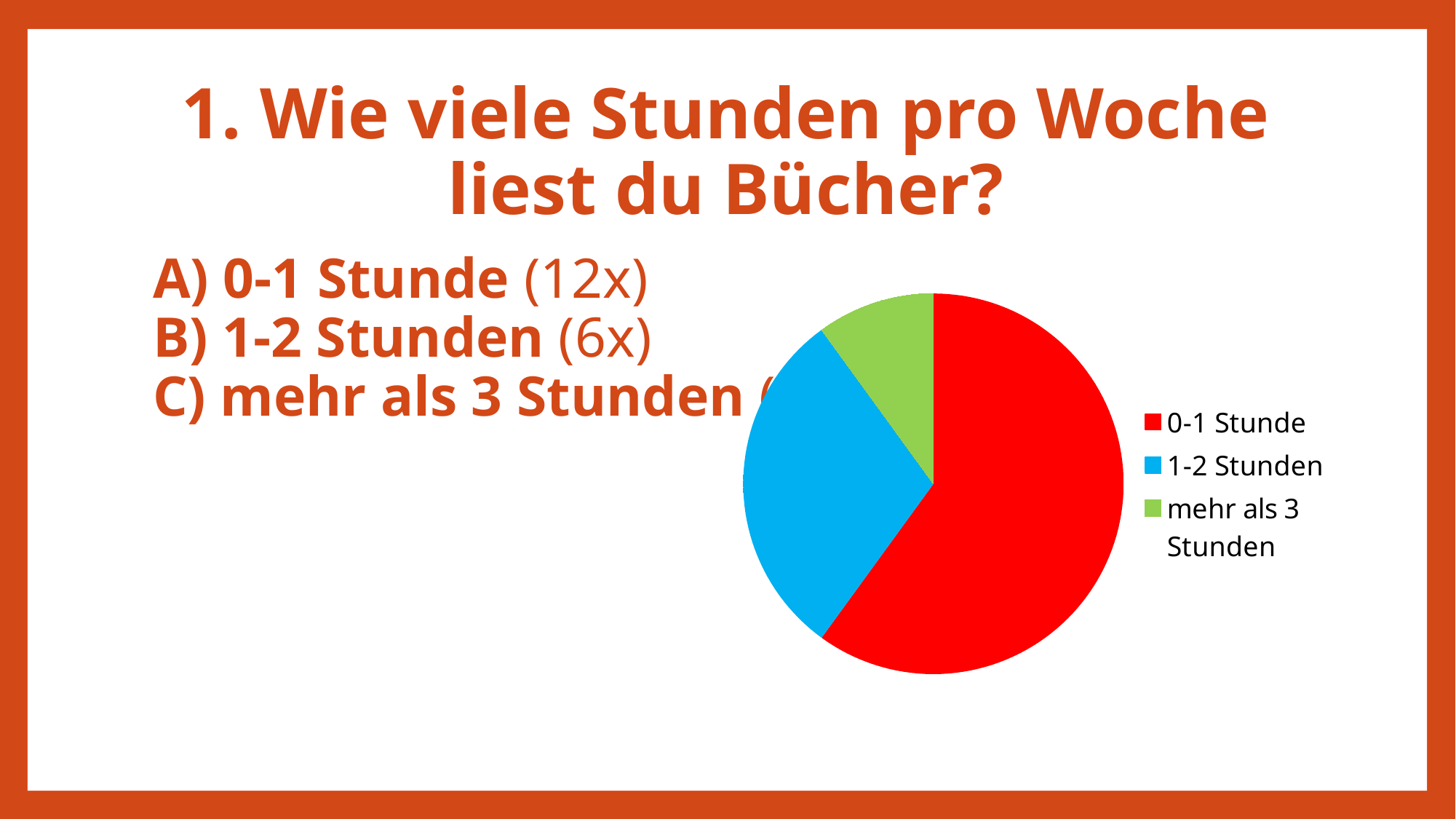
What kind of chart is shown on the slide? pie chart How many entries does the legend of the pie chart list? 3 Which category has the smallest slice in the pie chart? mehr als 3 Stunden Which slice is larger in the pie chart: 0-1 Stunde or 1-2 Stunden? 0-1 Stunde What colour is the slice for 0-1 Stunde in the pie chart? red How many responses are given on the slide for the category 1-2 Stunden? 6x Which category has the largest slice in the pie chart? 0-1 Stunde Which slice is larger in the pie chart: 1-2 Stunden or mehr als 3 Stunden? 1-2 Stunden Which category is shown in green in the pie chart? mehr als 3 Stunden How many slices does the pie chart have? 3 How many responses are given on the slide for the category 0-1 Stunde? 12x